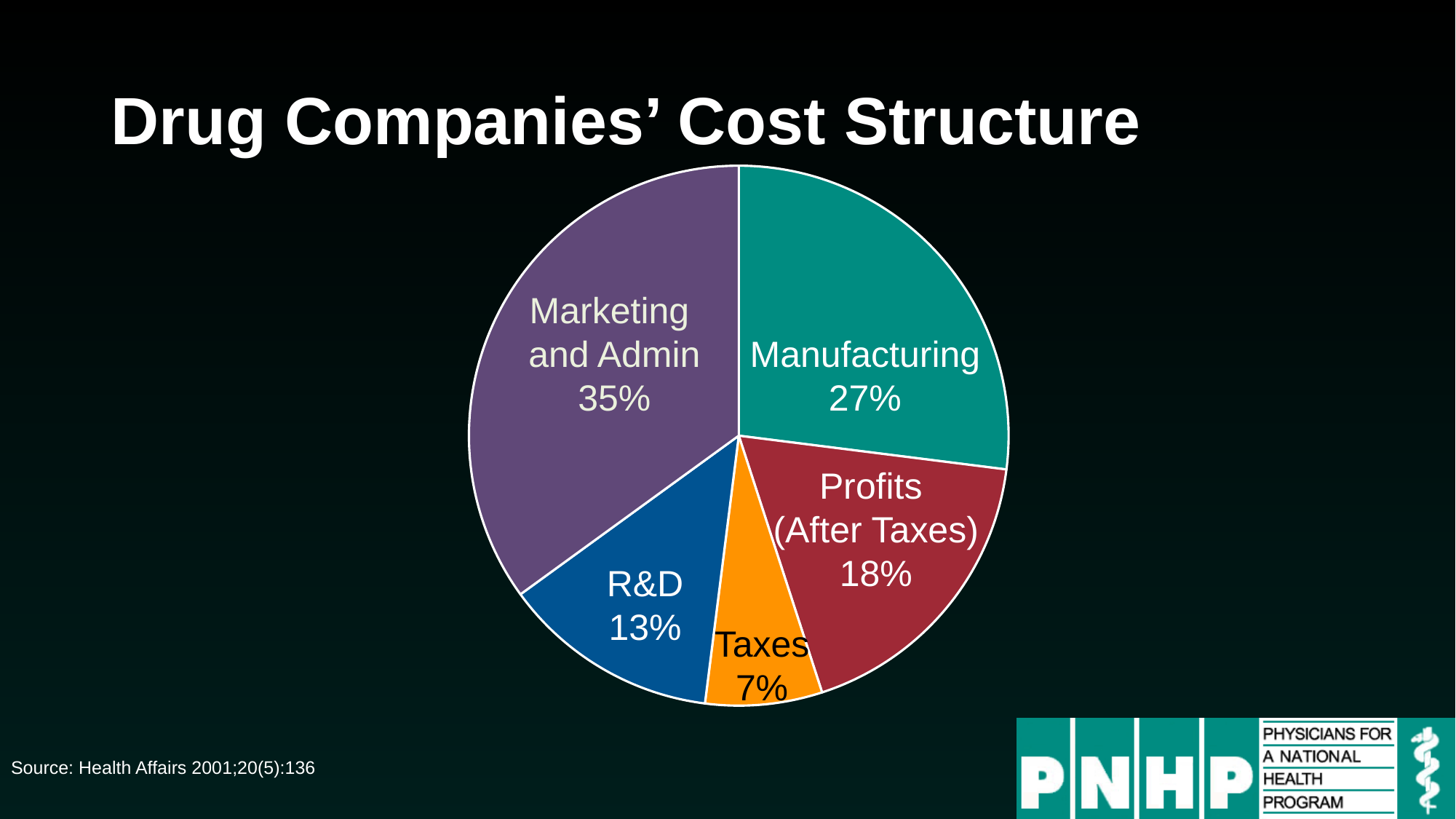
What share of drug companies' cost structure is Marketing and Admin? 35% What kind of chart is shown on the slide? Pie chart How many percentage points larger is Marketing and Admin than R&D? 22 How many slices does the pie chart have? 5 What is the title of the chart? Drug Companies' Cost Structure Which is larger, Manufacturing or Profits (After Taxes)? Manufacturing Which category has the largest share of the pie? Marketing and Admin What percentage does the Manufacturing slice represent? 27% What percentage is shown for Taxes? 7% Which category has the smallest share of the pie? Taxes What is the value shown for Profits (After Taxes)? 18% What percentage is shown for R&D? 13%